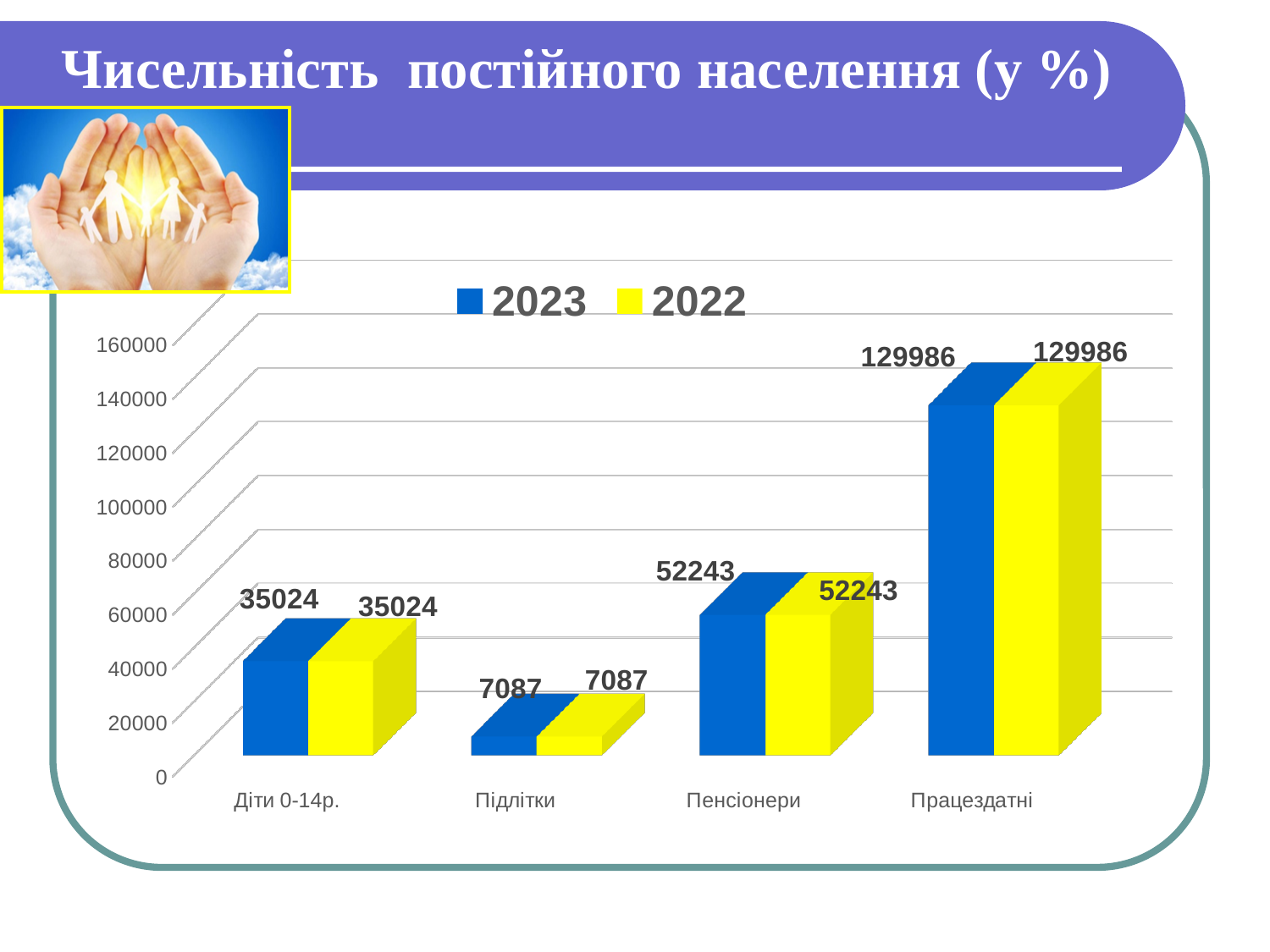
Which is larger in the 2023 series: Діти 0-14р. or Пенсіонери? Пенсіонери What is the difference between the 2023 values for Працездатні and Пенсіонери? 77743 What is the value for Пенсіонери in the 2023 series? 52243 How many series does the legend list? 2 How many categories are shown on the x axis? 4 Which category has the lowest value in the 2022 series? Підлітки What is the value for Підлітки in the 2022 series? 7087 What is the value for Діти 0-14р. in the 2022 series? 35024 Which category has the highest value in the 2023 series? Працездатні What kind of chart is shown on the slide? bar chart Is the 2022 value for Пенсіонери greater or less than 40000? greater What is the value for Працездатні in the 2023 series? 129986